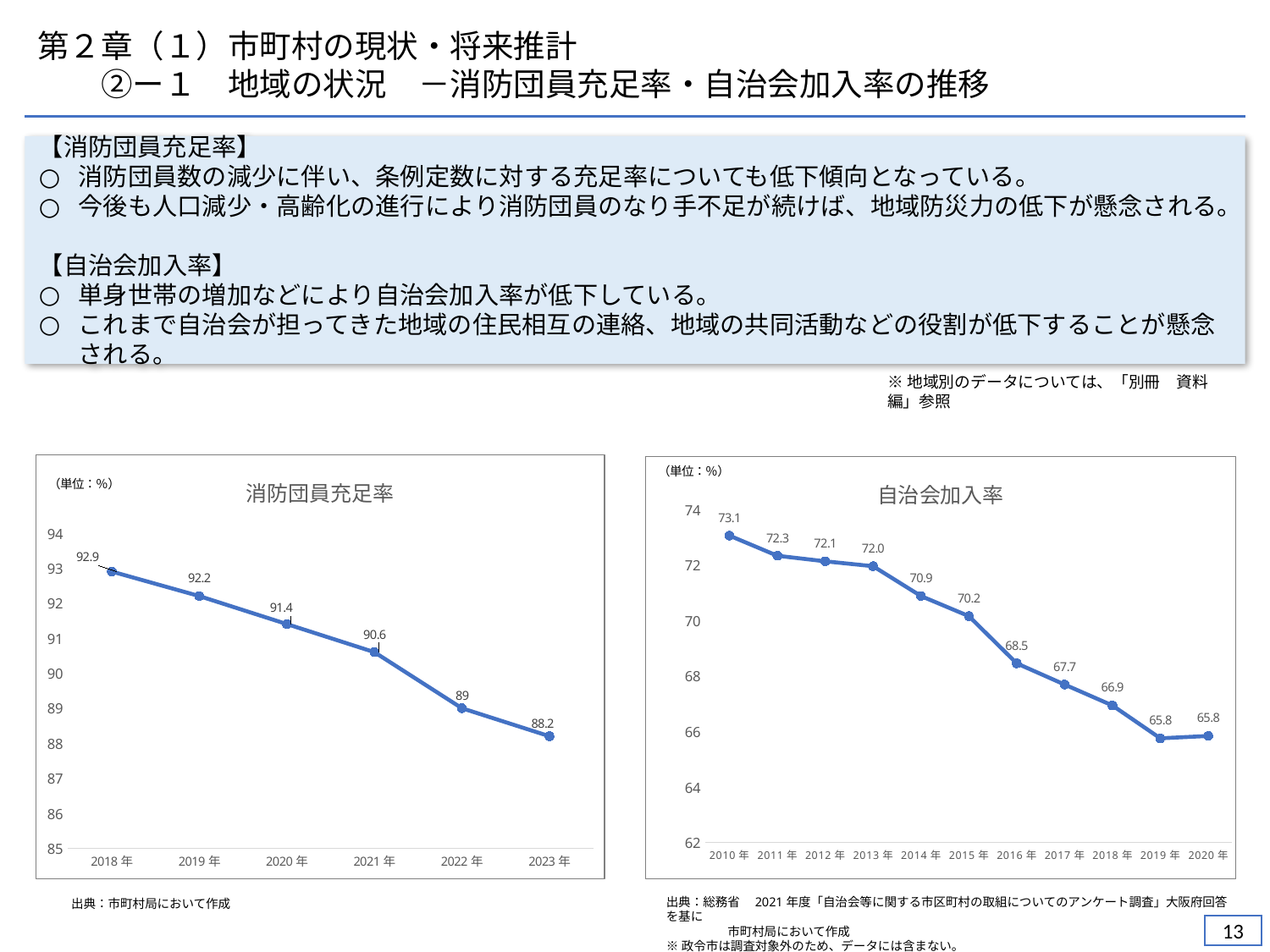
In the 消防団員充足率 chart, how many data points are plotted? 6 In the 消防団員充足率 chart, what is the difference between the 2018年 and 2023年 values? 4.7 In the 自治会加入率 chart, which year has the highest value? 2010年 What kind of chart is the 自治会加入率 chart? line chart In the 自治会加入率 chart, what is the value for 2014年? 70.9 In the 自治会加入率 chart, how many years are shown on the x axis? 11 In the 消防団員充足率 chart, what is the value for 2018年? 92.9 In the 消防団員充足率 chart, do the values rise or fall from 2018年 to 2023年? fall In the 消防団員充足率 chart, what is the value for 2023年? 88.2 In the 自治会加入率 chart, what is the difference between the 2010年 and 2020年 values? 7.3 In the 自治会加入率 chart, which is larger, the value for 2016年 or the value for 2018年? 2016年 In the 消防団員充足率 chart, which year has the lowest value? 2023年